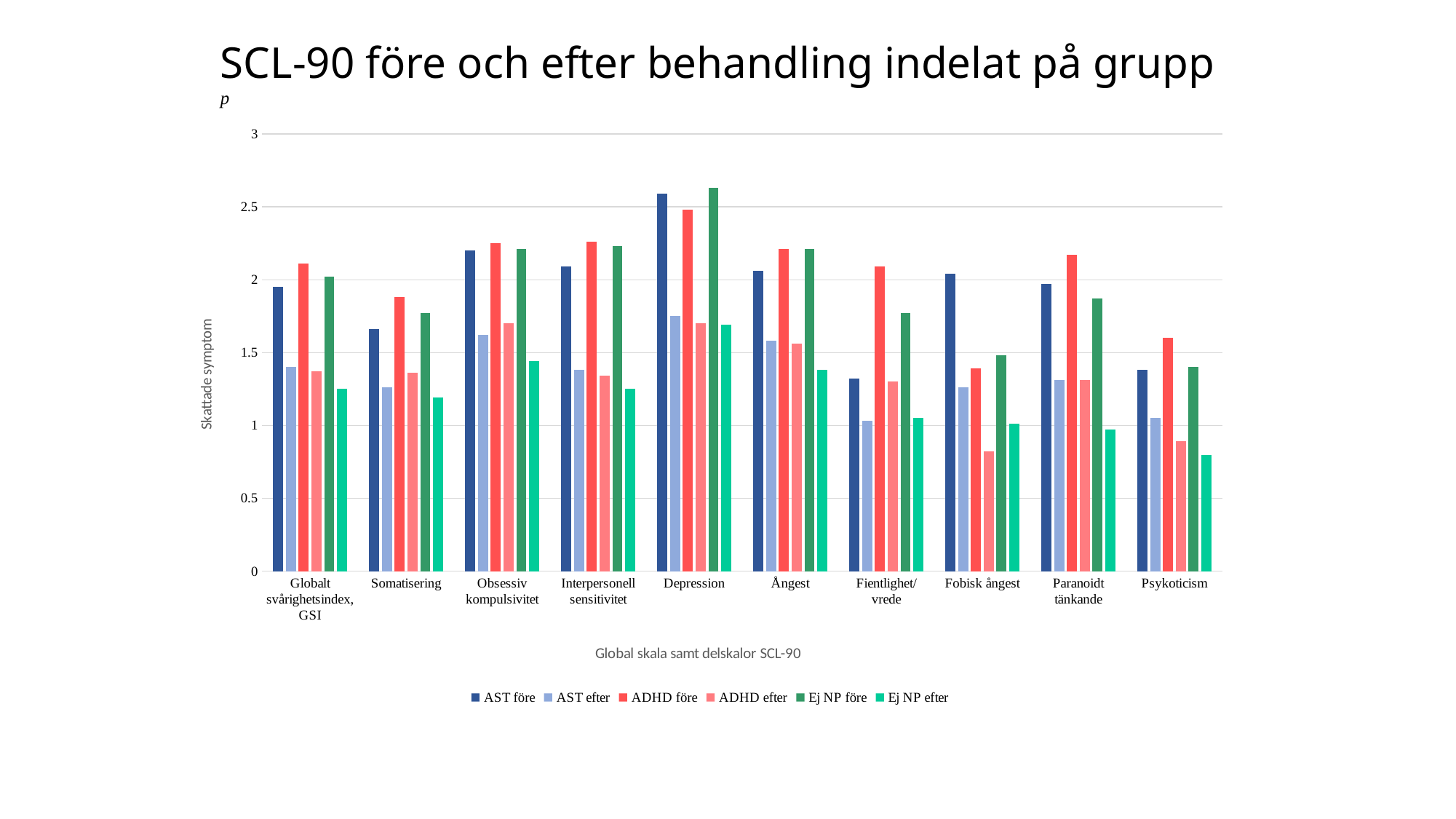
Which category has the highest value for Ej NP före? Depression Is the value for ADHD före in Depression greater or less than 2? greater What kind of chart is shown on the slide? bar chart How many series does the legend list? 6 Which category has the lowest value for Ej NP efter? Psykoticism In Fobisk ångest, which is larger: AST före or ADHD före? AST före Is the value for ADHD efter in Fobisk ångest greater or less than 1? less In Fientlighet/vrede, which is larger: AST före or ADHD före? ADHD före How many categories are shown along the x axis? 10 What is the title of the vertical axis? Skattade symptom Is the value for AST efter in Depression greater or less than 1.5? greater What is the title of the horizontal axis? Global skala samt delskalor SCL-90